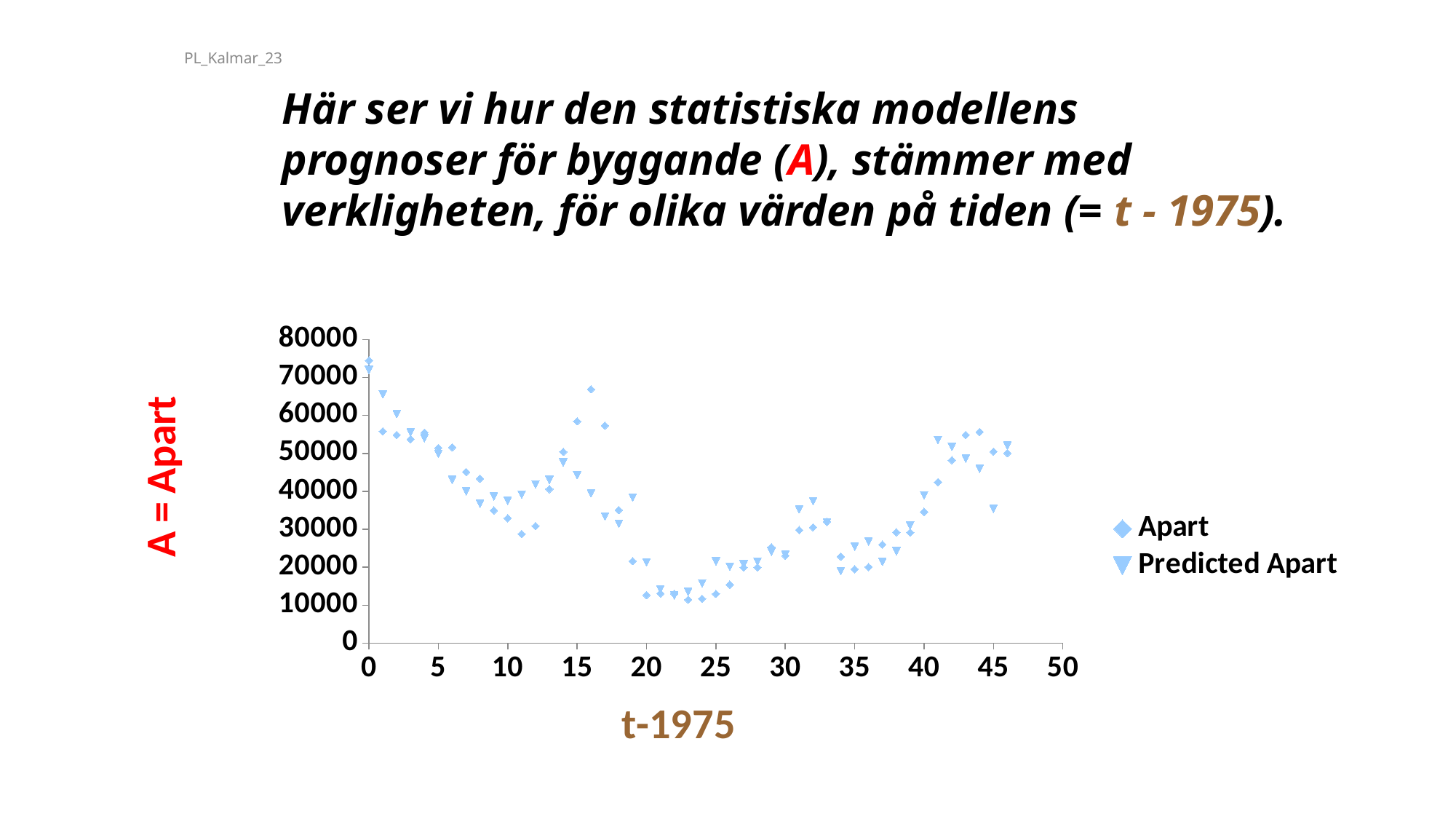
What is the title of the x axis? t-1975 What is the highest value shown on the y axis? 80000 Is the Apart value at t-1975 = 0 greater or less than 70000? greater Is the Apart value at t-1975 = 16 greater or less than 60000? greater Do the Apart values rise or fall between t-1975 = 0 and t-1975 = 10? fall How many series does the legend list? 2 What kind of chart is shown on the slide? scatter chart Is the Apart value at t-1975 = 44 greater or less than 50000? greater What are the two series named in the legend? Apart and Predicted Apart Do the Apart values rise or fall between t-1975 = 35 and t-1975 = 44? rise